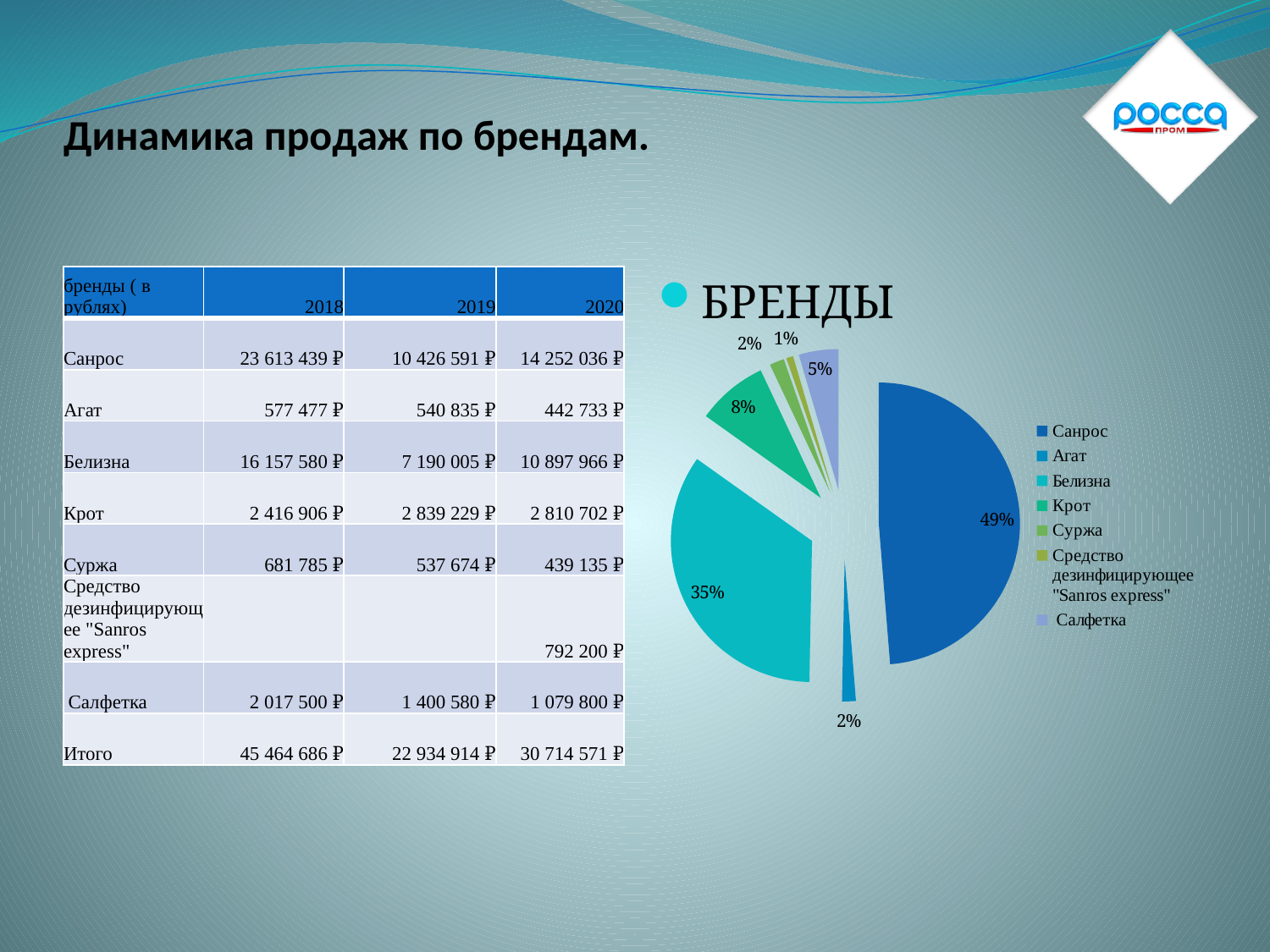
What share of the pie chart does Крот have? 8% Which brand has the largest slice in the pie chart? Санрос What kind of chart is shown on the slide? pie chart In the pie chart, which is larger: the slice for Белизна or the slice for Крот? Белизна What is the title of the pie chart? БРЕНДЫ What share of the pie chart does Белизна have? 35% What share of the pie chart does Салфетка have? 5% What is the difference in percentage points between the Санрос slice and the Белизна slice in the pie chart? 14% Which brand has the smallest slice in the pie chart? Средство дезинфицирующее "Sanros express" How many slices does the pie chart have? 7 How many entries does the legend of the pie chart list? 7